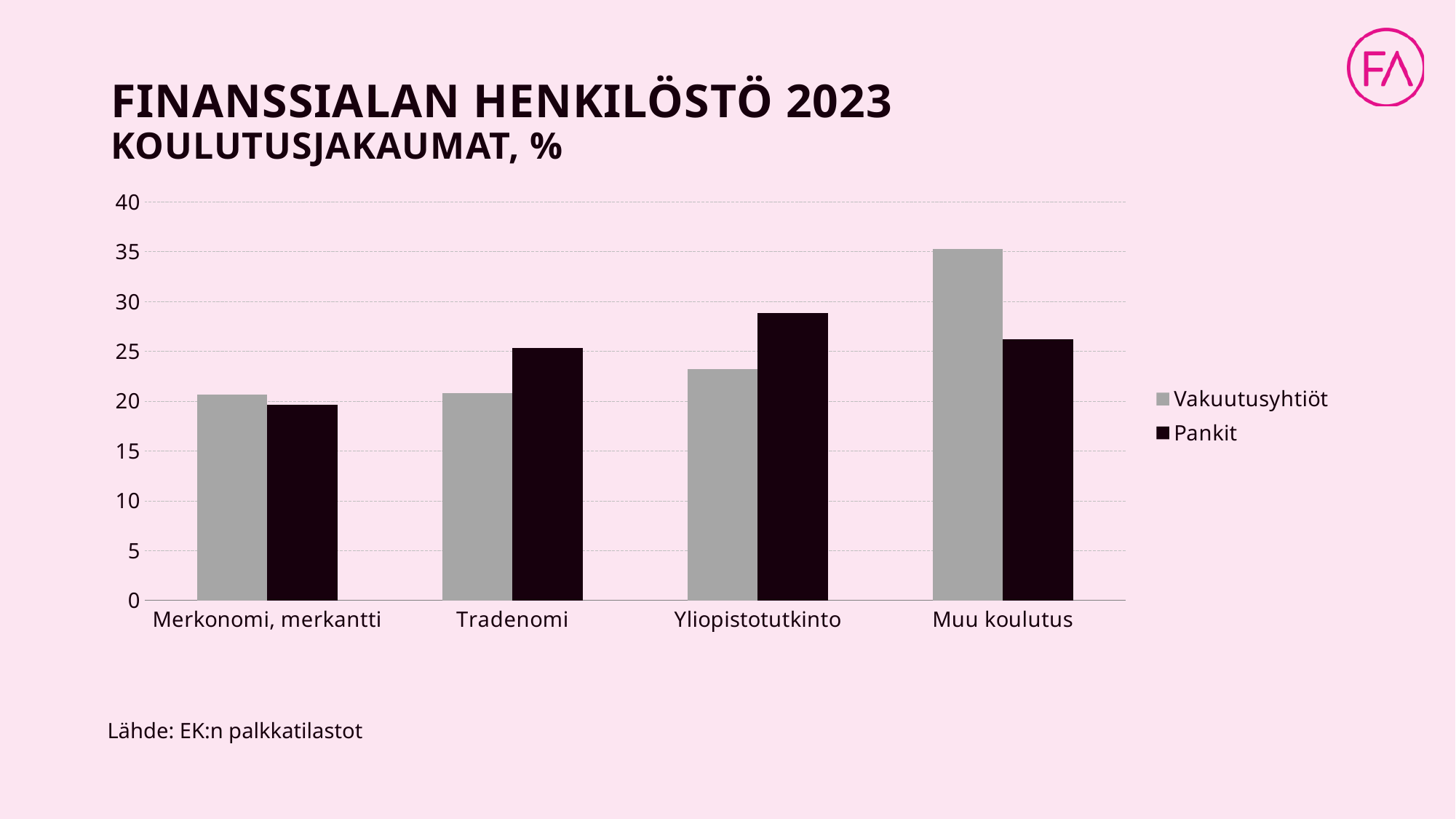
Which education category has the highest value for Vakuutusyhtiöt? Muu koulutus What kind of chart is shown on the slide? bar chart What is the subtitle of the chart below the main title? KOULUTUSJAKAUMAT, % Which education category has the highest value for Pankit? Yliopistotutkinto For Muu koulutus, which is larger: Vakuutusyhtiöt or Pankit? Vakuutusyhtiöt Which education category has the lowest value for Pankit? Merkonomi, merkantti How many education categories are shown on the x axis? 4 Is the value for Pankit in Yliopistotutkinto greater or less than 25? greater For Tradenomi, which is larger: Vakuutusyhtiöt or Pankit? Pankit How many series does the legend list? 2 Is the value for Vakuutusyhtiöt in Yliopistotutkinto greater or less than 25? less Is the value for Vakuutusyhtiöt in Muu koulutus greater or less than 30? greater